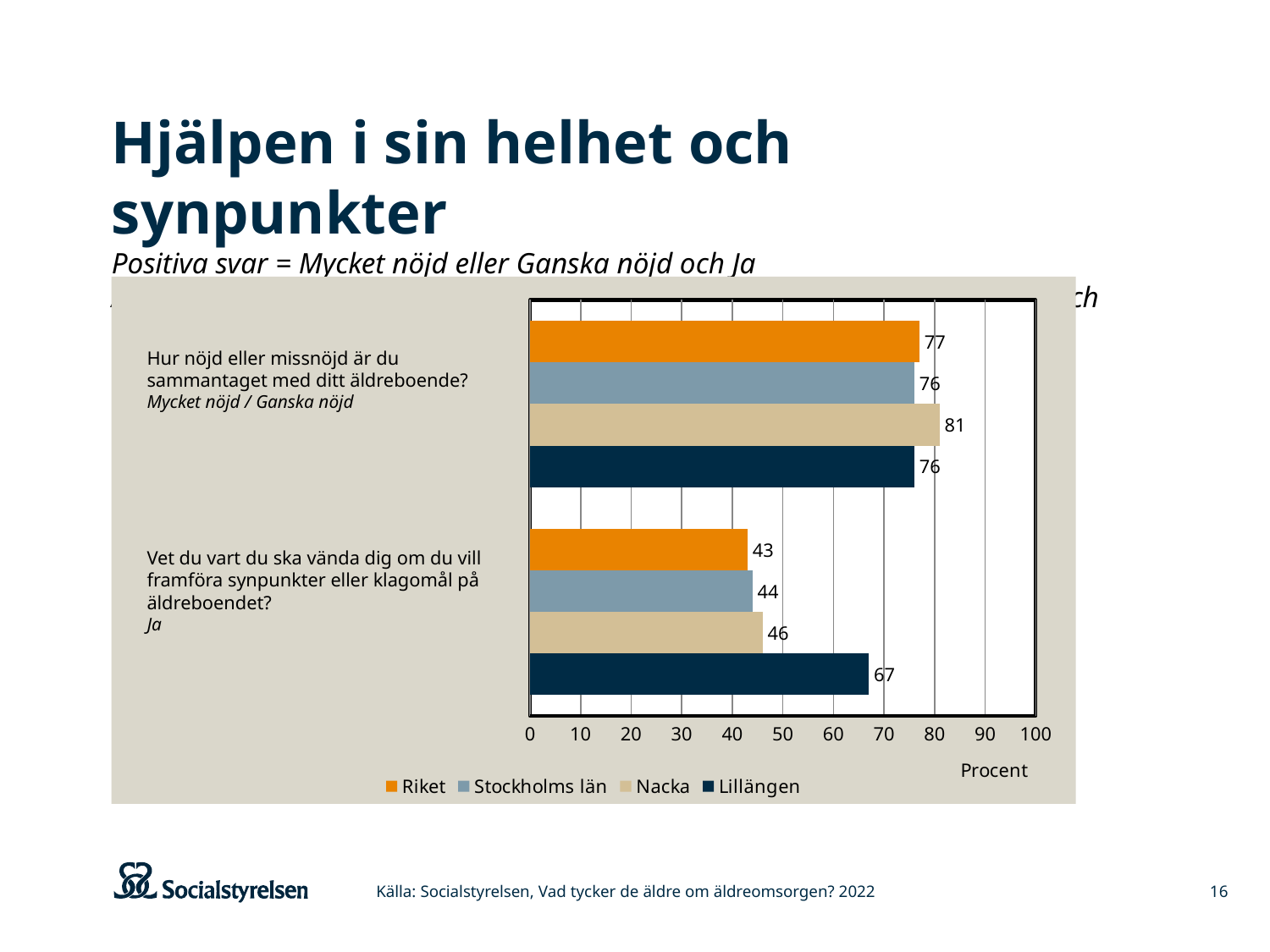
On the question "Vet du vart du ska vända dig om du vill framföra synpunkter eller klagomål på äldreboendet?", which is larger: Lillängen or Nacka? Lillängen What value is shown for Lillängen on the question "Vet du vart du ska vända dig om du vill framföra synpunkter eller klagomål på äldreboendet?"? 67 What is the difference between Lillängen and Riket on the question "Vet du vart du ska vända dig om du vill framföra synpunkter eller klagomål på äldreboendet?"? 24 How many series does the legend list? 4 What kind of chart is shown on the slide? Bar chart What value is shown for Nacka on the question "Hur nöjd eller missnöjd är du sammantaget med ditt äldreboende?"? 81 What unit is labelled on the horizontal axis of the chart? Procent Which series has the highest value on the question "Hur nöjd eller missnöjd är du sammantaget med ditt äldreboende?"? Nacka Is the value for Lillängen on the question "Vet du vart du ska vända dig om du vill framföra synpunkter eller klagomål på äldreboendet?" greater or less than 60? greater What value is shown for Riket on the question "Vet du vart du ska vända dig om du vill framföra synpunkter eller klagomål på äldreboendet?"? 43 Which series has the lowest value on the question "Vet du vart du ska vända dig om du vill framföra synpunkter eller klagomål på äldreboendet?"? Riket What is the difference between Nacka and Stockholms län on the question "Hur nöjd eller missnöjd är du sammantaget med ditt äldreboende?"? 5